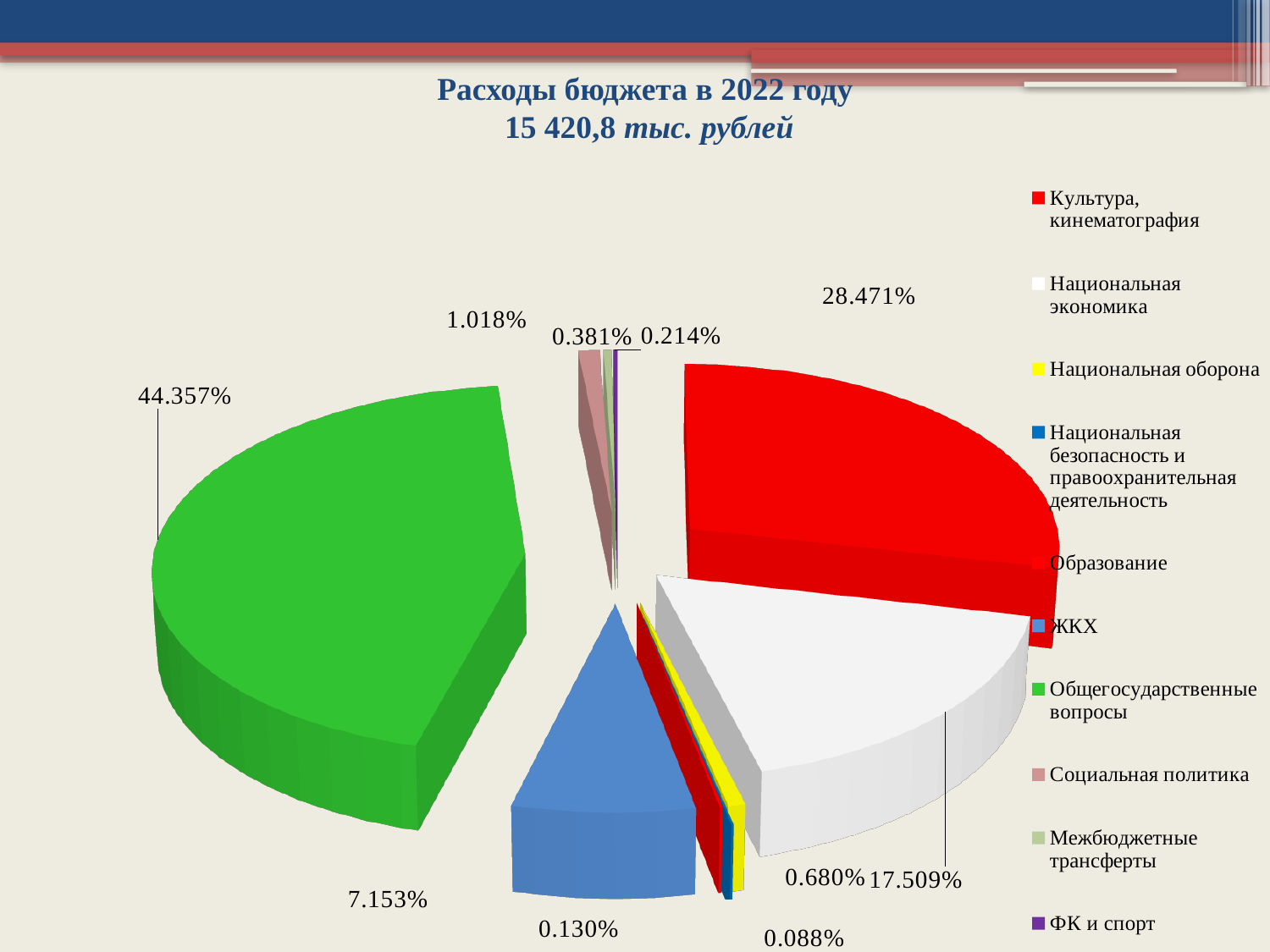
What kind of chart is shown on the slide? pie chart What share of the pie does Культура, кинематография have? 28.471% Which category has the largest share of the pie? Общегосударственные вопросы What share of the pie does ЖКХ have? 7.153% What share of the pie does Общегосударственные вопросы have? 44.357% Which category has the smallest share of the pie? Национальная безопасность и правоохранительная деятельность What share of the pie does Национальная экономика have? 17.509% What share of the pie does Социальная политика have? 1.018% How many categories does the legend list? 10 Which is larger: the share for Национальная экономика or the share for ЖКХ? Национальная экономика What total budget expenditure amount is stated in the chart title? 15 420,8 тыс. рублей What is the difference in percentage points between Общегосударственные вопросы and Культура, кинематография? 15.886%